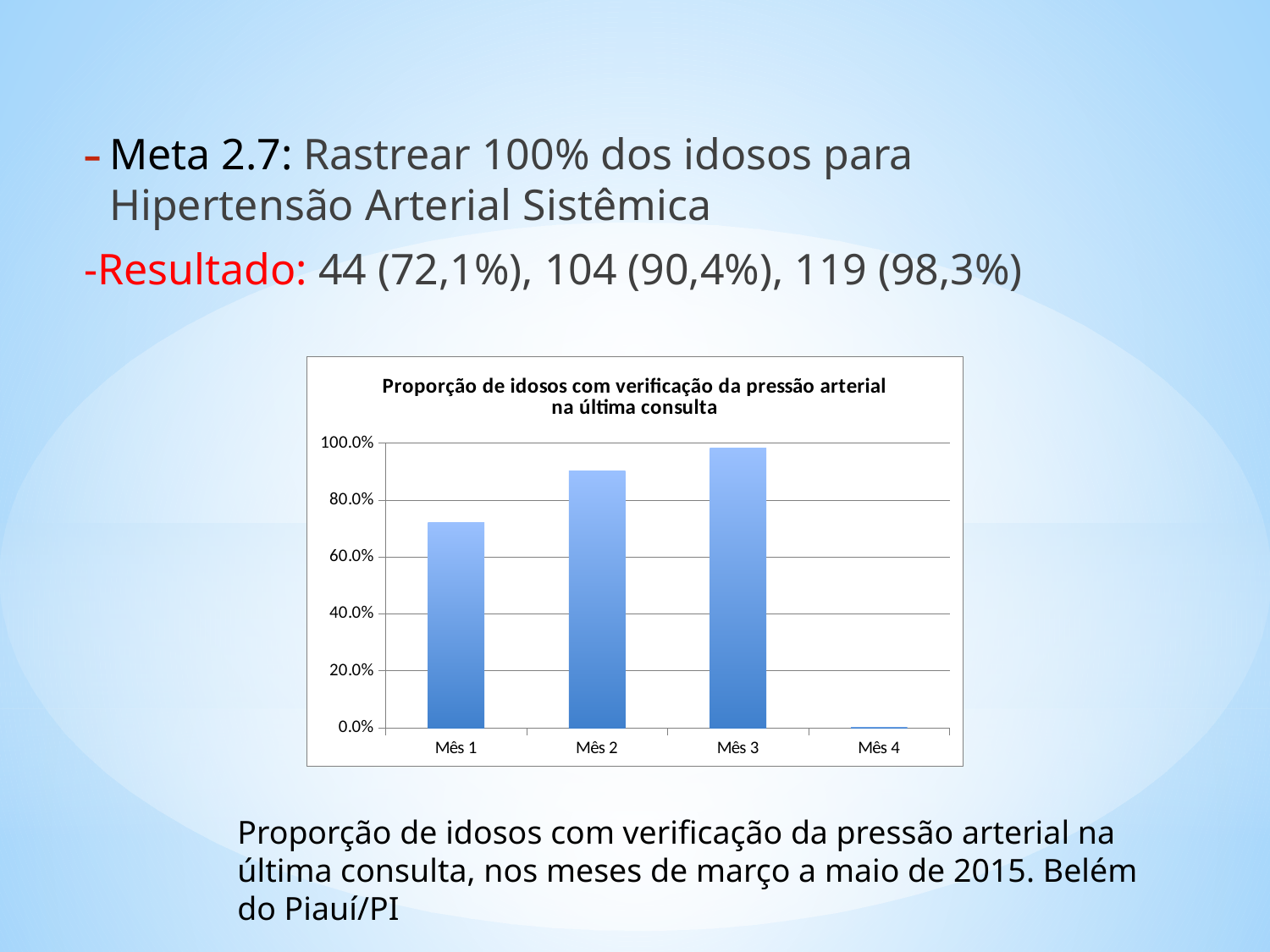
Is the value for Mês 1 greater or less than 80.0%? less Which is larger, the value for Mês 1 or the value for Mês 2? Mês 2 Is the value for Mês 4 greater or less than 20.0%? less Which month has the highest bar in the chart? Mês 3 Is the value for Mês 1 greater or less than 60.0%? greater What kind of chart is shown on the slide? bar chart What is the title of the chart? Proporção de idosos com verificação da pressão arterial na última consulta Which month has the lowest bar in the chart? Mês 4 Do the values rise or fall from Mês 1 to Mês 3? rise How many categories are shown on the x axis of the chart? 4